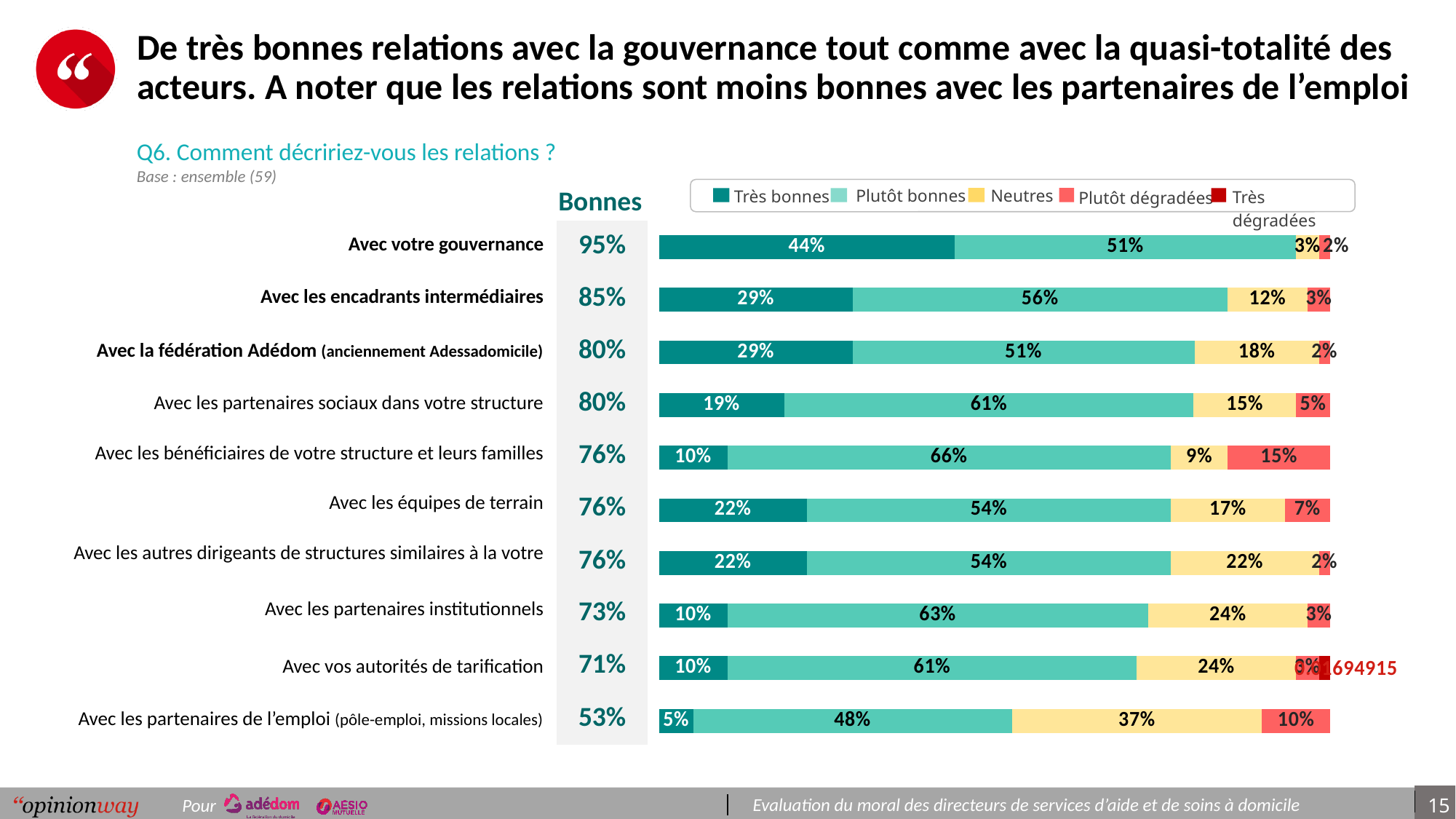
Which category has the highest 'Très bonnes' value? Avec votre gouvernance How many categories (relationship types) are plotted in the chart? 10 Which category has the highest 'Neutres' value? Avec les partenaires de l'emploi What kind of chart is shown on the slide? Stacked bar chart Which category has the lowest 'Très bonnes' value? Avec les partenaires de l'emploi Which has a larger 'Neutres' value: 'Avec les partenaires institutionnels' or 'Avec les équipes de terrain'? Avec les partenaires institutionnels What is the 'Plutôt dégradées' value for 'Avec les bénéficiaires de votre structure et leurs familles'? 15% What is the difference between the 'Plutôt bonnes' value for 'Avec les bénéficiaires de votre structure et leurs familles' and for 'Avec les partenaires de l'emploi'? 18 percentage points What is the 'Très bonnes' value for 'Avec votre gouvernance'? 44% What is the 'Plutôt bonnes' value for 'Avec les bénéficiaires de votre structure et leurs familles'? 66% What is the 'Bonnes' total shown for 'Avec les partenaires sociaux dans votre structure'? 80% How many series does the legend list? 5